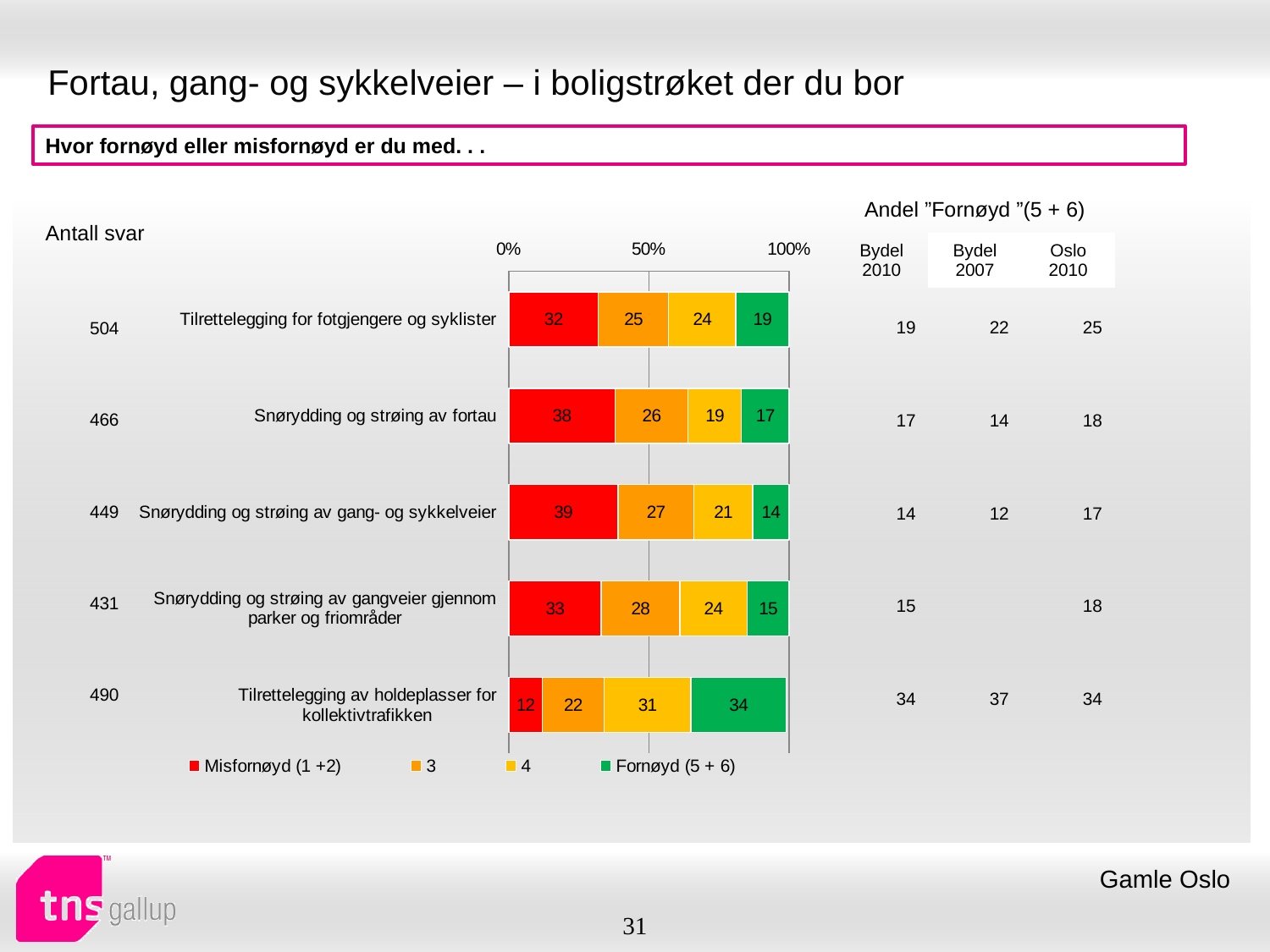
What is the value of the "3" segment for "Snørydding og strøing av gang- og sykkelveier"? 27 Which is larger: the Fornøyd (5 + 6) value for "Tilrettelegging for fotgjengere og syklister" or for "Snørydding og strøing av fortau"? Tilrettelegging for fotgjengere og syklister What is the value of the "4" segment for "Snørydding og strøing av gangveier gjennom parker og friområder"? 24 What kind of chart is shown on the slide? Stacked bar chart Which category has the highest Fornøyd (5 + 6) value? Tilrettelegging av holdeplasser for kollektivtrafikken What is the total of the stacked bar for "Snørydding og strøing av fortau"? 100 What is the value of the Fornøyd (5 + 6) segment for "Tilrettelegging av holdeplasser for kollektivtrafikken"? 34 What is the difference between the Misfornøyd (1 +2) values for "Snørydding og strøing av gang- og sykkelveier" and "Tilrettelegging for fotgjengere og syklister"? 7 Which category has the lowest Misfornøyd (1 +2) value? Tilrettelegging av holdeplasser for kollektivtrafikken How many categories are shown in the bar chart? 5 How many series does the legend list? 4 What is the value of the Misfornøyd (1 +2) segment for "Snørydding og strøing av fortau"? 38